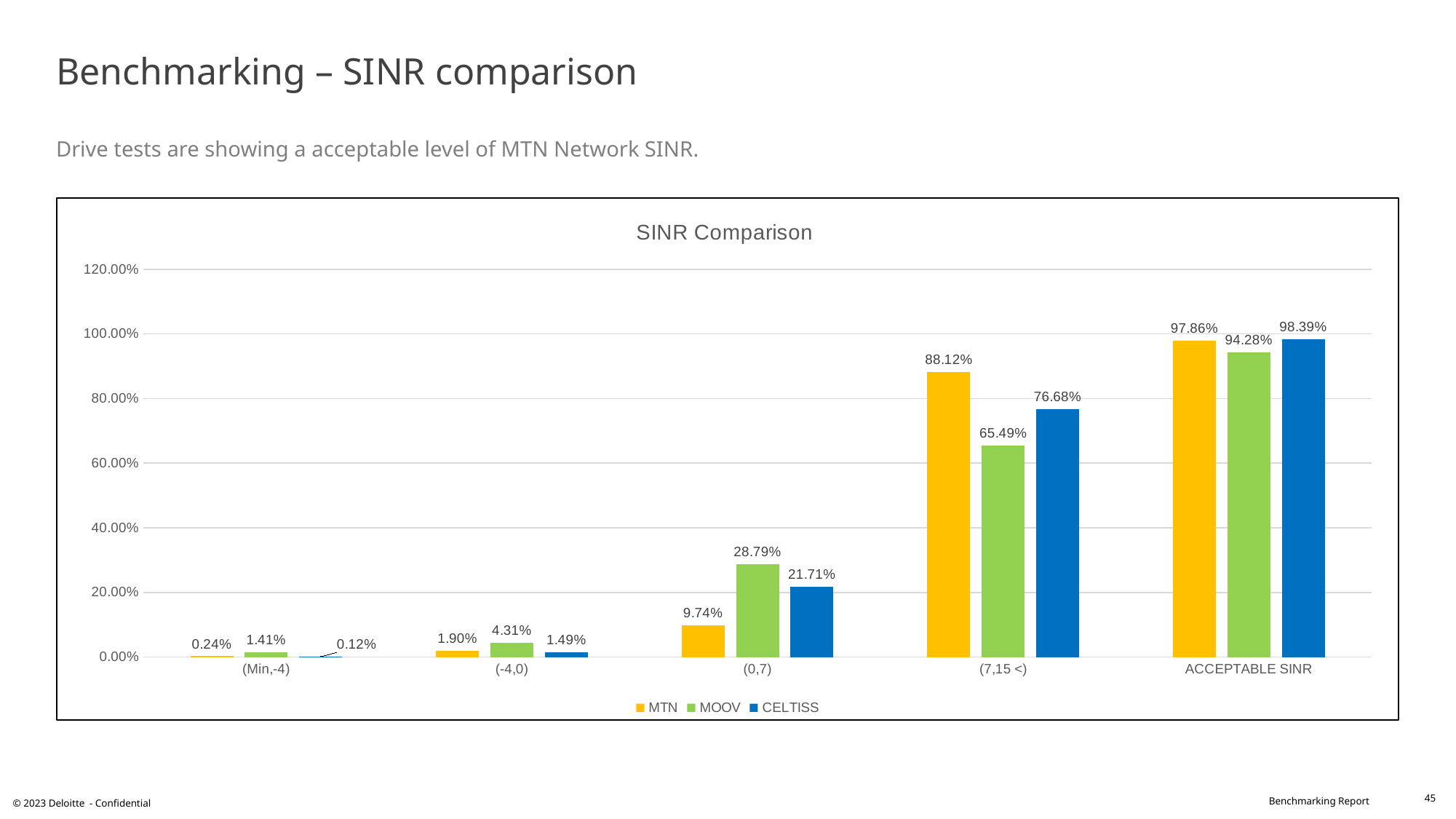
What is the CELTISS value for ACCEPTABLE SINR? 98.39% Which is larger in the (0,7) category, the MOOV value or the CELTISS value? MOOV What is the MOOV value for the (0,7) category? 28.79% What kind of chart is shown on the slide? bar chart Which series has the highest value in the (7,15 <) category? MTN How many series does the legend list? 3 What is the MTN value for the (7,15 <) category? 88.12% What is the title of the chart? SINR Comparison Is the CELTISS value for (7,15 <) greater or less than 80.00%? less How many categories are shown on the x axis? 5 What is the difference between the MTN and MOOV values in the (7,15 <) category? 22.63% Which series has the lowest value in the ACCEPTABLE SINR category? MOOV